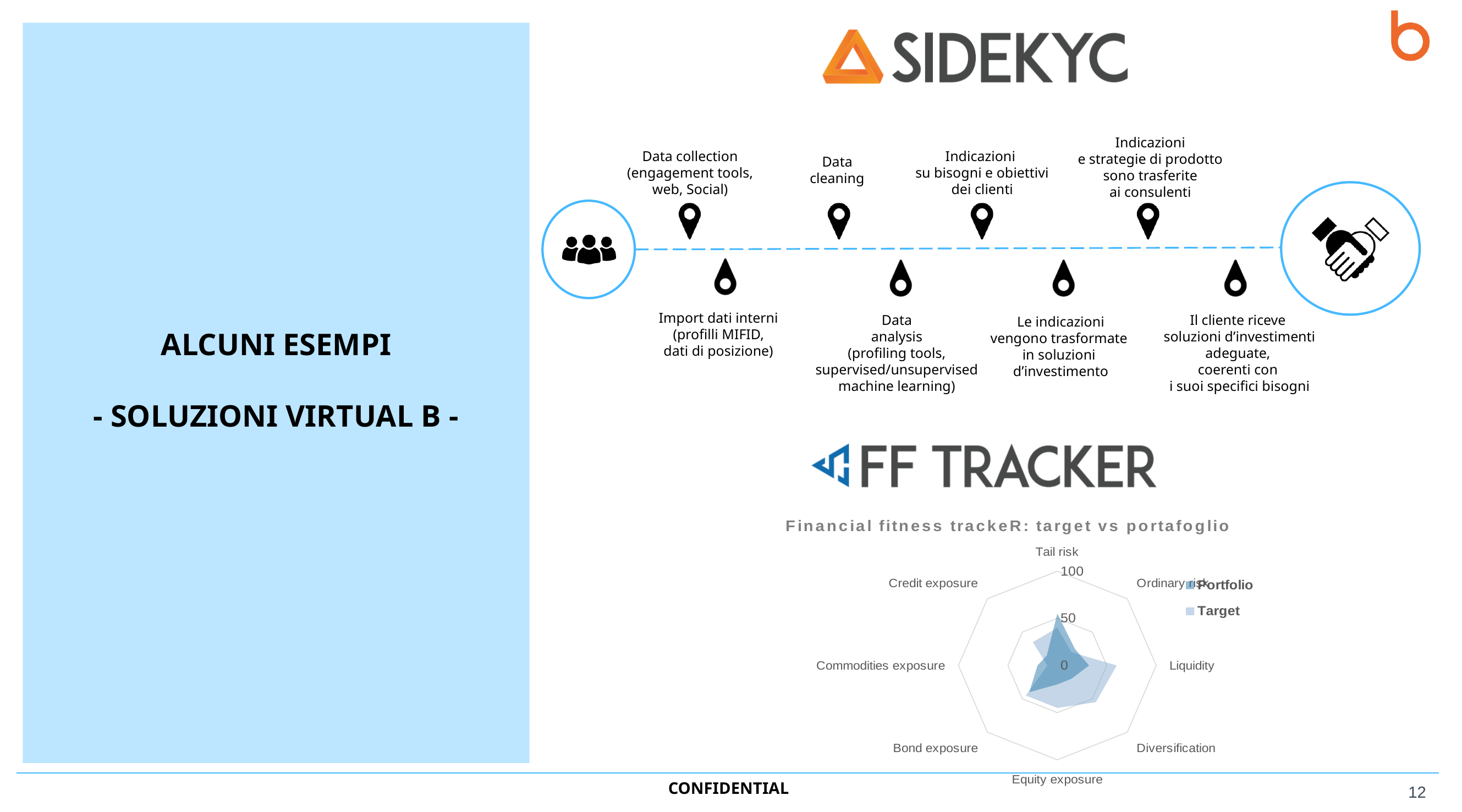
What is the title of the radar chart? Financial fitness trackeR: target vs portafoglio Is the Portfolio value for Tail risk greater or less than 100? less What is the highest value shown on the radar chart's scale? 100 Is the Target value for Commodities exposure greater or less than 50? less How many categories (axes) does the radar chart have? 8 What are the two series named in the legend of the radar chart? Portfolio and Target What kind of chart is shown under the FF TRACKER logo? Radar chart Is the Portfolio value for Diversification greater or less than 100? less How many series does the legend of the radar chart list? 2